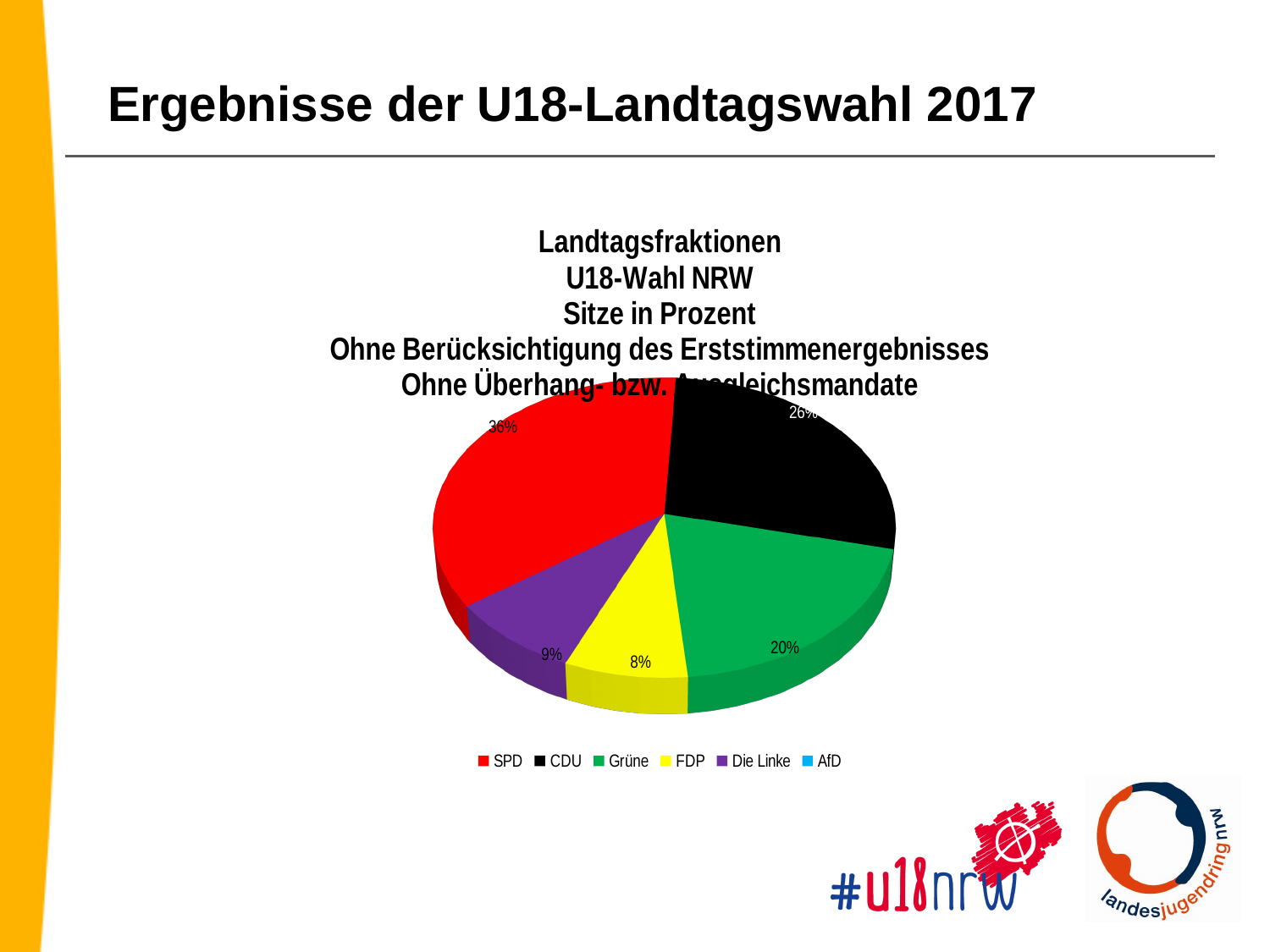
What colour represents the SPD in the pie chart? red How many parties are listed in the chart legend? 6 What share of seats does the Grüne slice show? 20% What share of seats does the FDP slice show? 8% Which is smaller, the FDP slice or the Die Linke slice? FDP What share of seats does the CDU slice show? 28% What share of seats does the Die Linke slice show? 9% What share of seats does the SPD slice show? 36% Which is larger, the CDU slice or the Grüne slice? CDU By how many percentage points does the SPD share exceed the Grüne share? 16 percentage points Which party has the largest slice of the pie? SPD What kind of chart is shown on the slide? pie chart